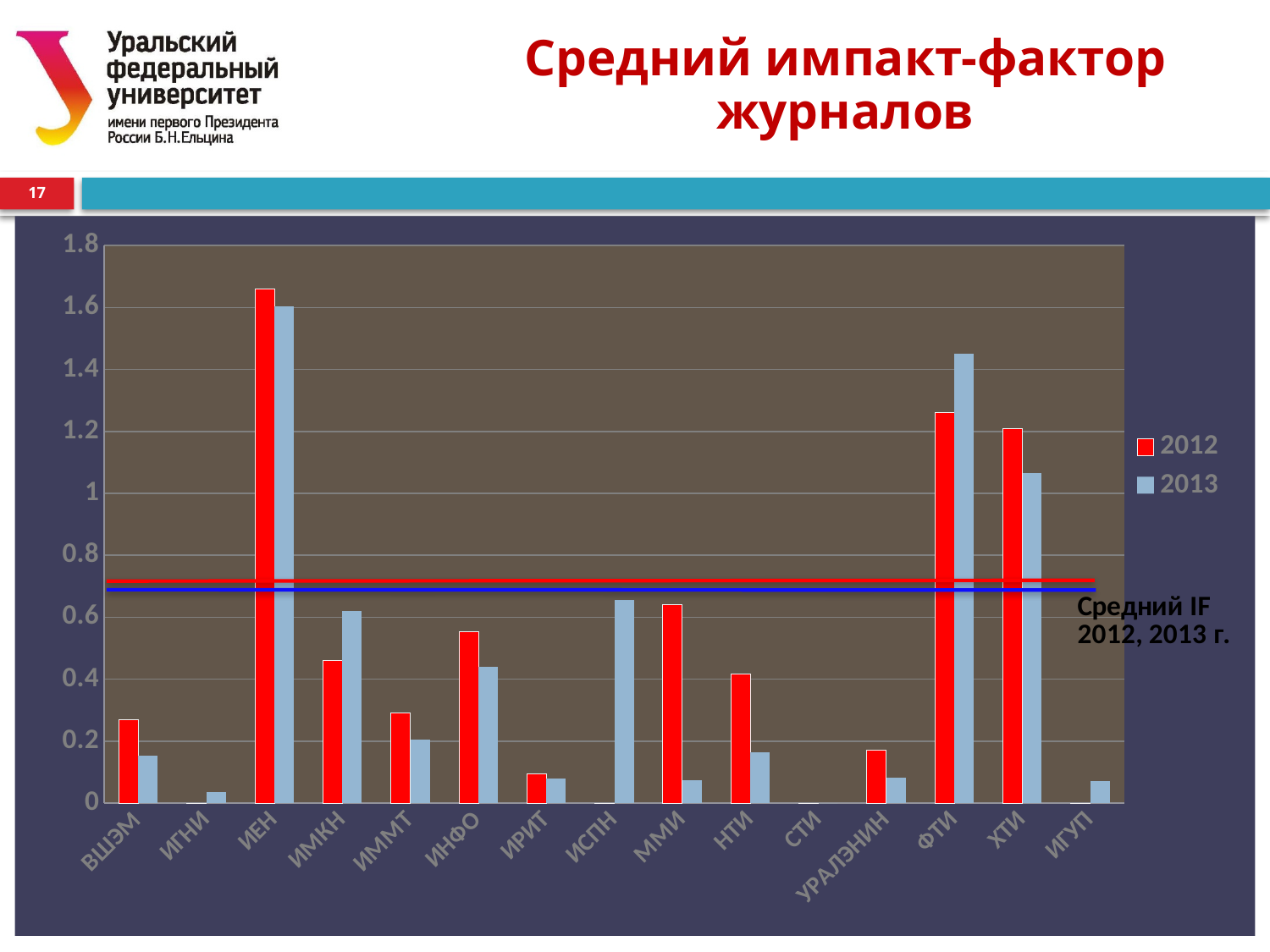
What are the two entries in the chart legend? 2012 and 2013 Is the 2013 value for ФТИ greater or less than 1.2? greater Which category has the highest value for 2012? ИЕН For ФТИ, which series has the larger value, 2012 or 2013? 2013 How many categories are shown on the x axis? 15 What kind of chart is shown on the slide? bar chart For ММИ, which series has the larger value, 2012 or 2013? 2012 Is the 2012 value for ВШЭМ greater or less than 0.4? less Which category has the highest value for 2013? ИЕН Is the 2012 value for ИЕН greater or less than 1.4? greater How many series does the legend list? 2 What do the horizontal lines across the chart represent, according to the label next to them? Средний IF 2012, 2013 г.